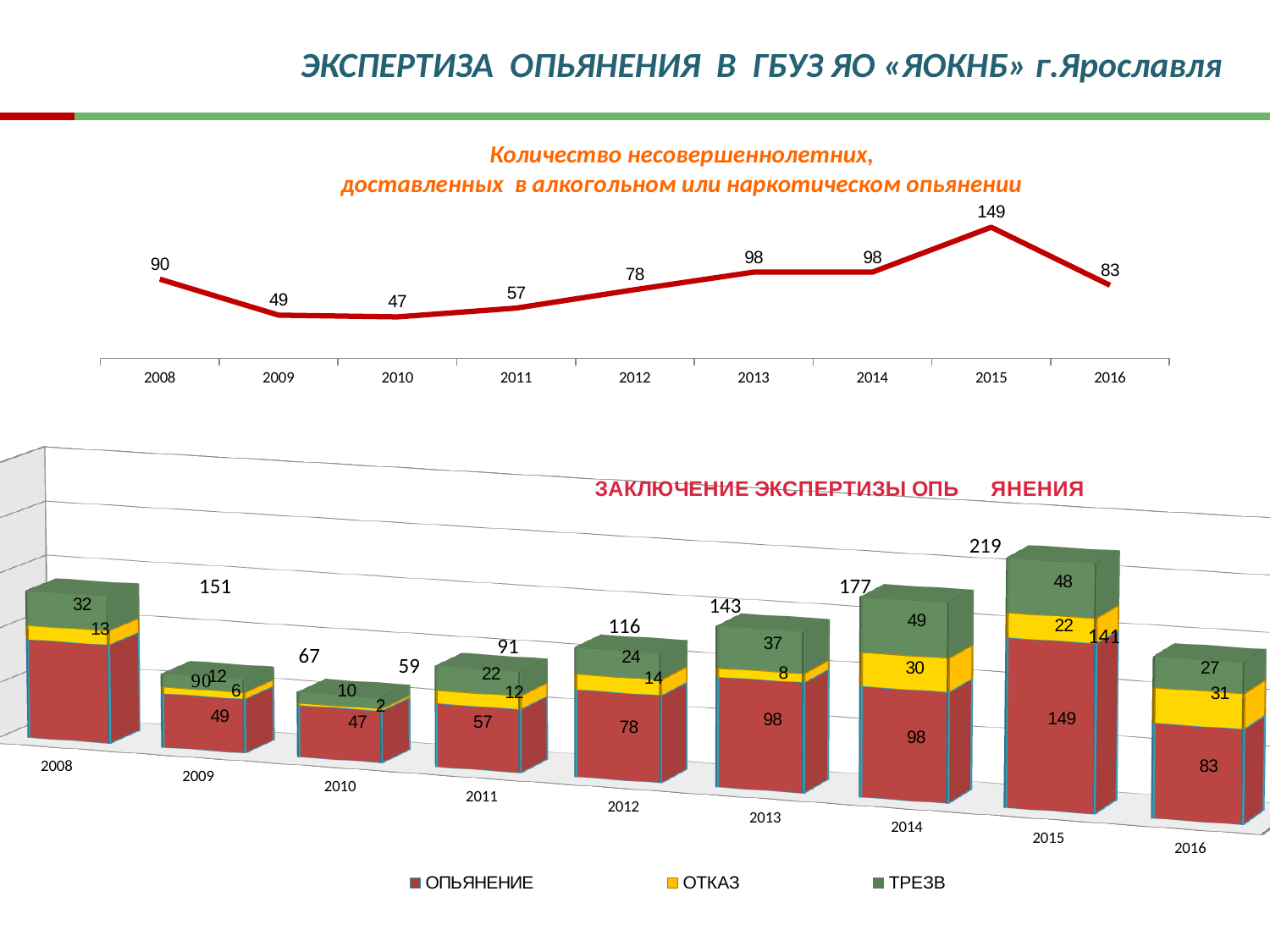
How many series does the legend of the bottom chart 'ЗАКЛЮЧЕНИЕ ЭКСПЕРТИЗЫ ОПЬЯНЕНИЯ' list? 3 In the bottom chart 'ЗАКЛЮЧЕНИЕ ЭКСПЕРТИЗЫ ОПЬЯНЕНИЯ', what is the ОТКАЗ value for 2014? 30 In the top line chart, what is the value for 2015? 149 How many years are plotted in the top line chart? 9 In the top line chart, which year has the lowest value? 2010 In the top line chart, do the values rise or fall from 2010 to 2013? Rise What kind of chart is the top chart titled 'Количество несовершеннолетних, доставленных в алкогольном или наркотическом опьянении'? Line chart In the top line chart, what is the difference between the values for 2015 and 2016? 66 In the bottom chart 'ЗАКЛЮЧЕНИЕ ЭКСПЕРТИЗЫ ОПЬЯНЕНИЯ', which year has the larger ТРЕЗВ value, 2013 or 2014? 2014 In the bottom chart 'ЗАКЛЮЧЕНИЕ ЭКСПЕРТИЗЫ ОПЬЯНЕНИЯ', what is the total of the stacked bar for 2015? 219 In the top line chart, which year has the highest value? 2015 In the bottom chart 'ЗАКЛЮЧЕНИЕ ЭКСПЕРТИЗЫ ОПЬЯНЕНИЯ', what is the ТРЕЗВ value for 2015? 48